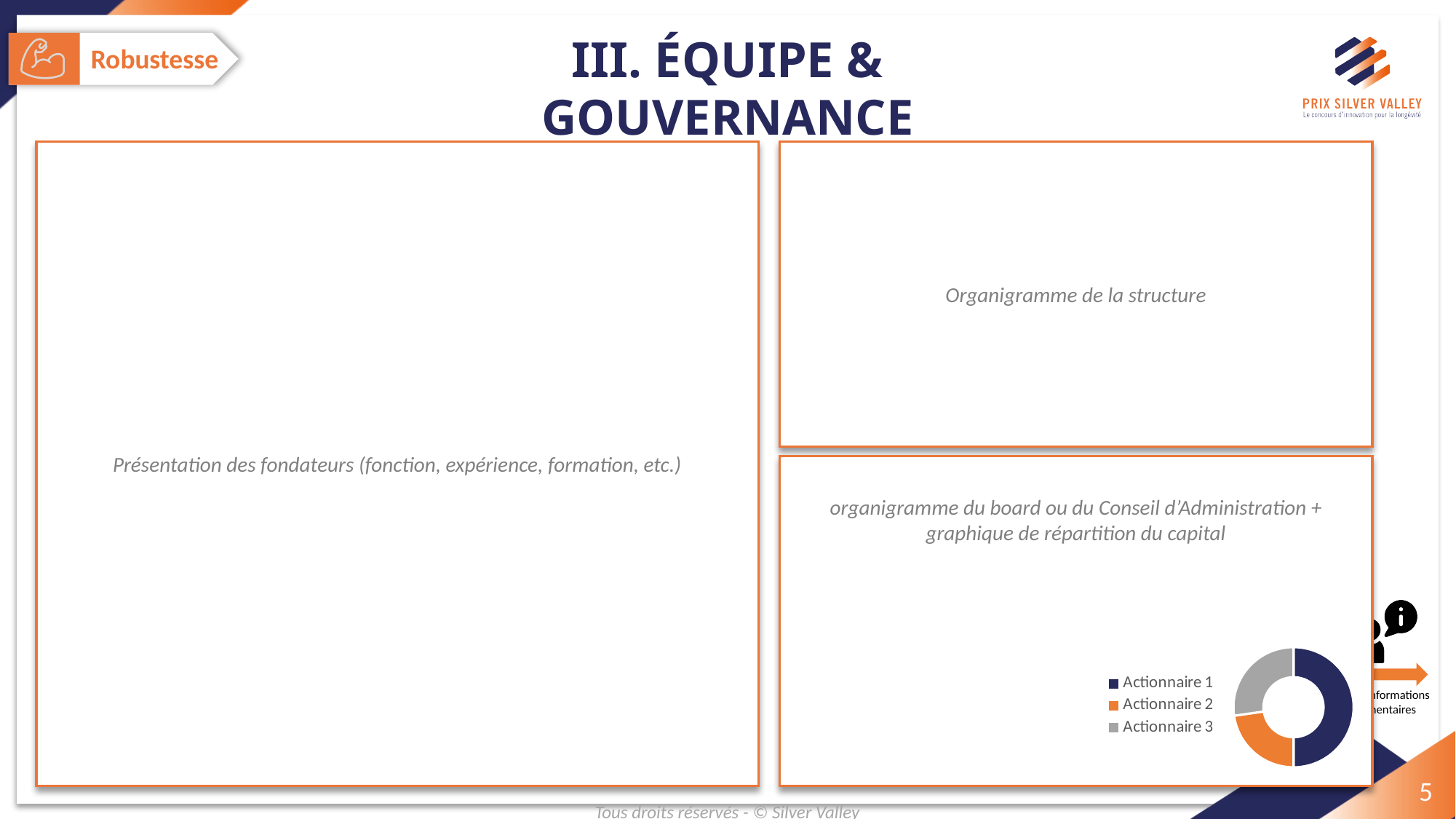
In the doughnut chart, which slice is larger: Actionnaire 1 or Actionnaire 2? Actionnaire 1 What kind of chart is shown in the bottom-right box of the slide? doughnut chart What colour represents Actionnaire 2 in the doughnut chart? orange Which legend entry of the doughnut chart is shown in grey? Actionnaire 3 In the doughnut chart, which slice is larger: Actionnaire 2 or Actionnaire 3? Actionnaire 3 How many entries does the legend of the doughnut chart list? 3 How many slices does the doughnut chart have? 3 Which shareholder has the largest slice in the doughnut chart? Actionnaire 1 Which shareholder has the smallest slice in the doughnut chart? Actionnaire 2